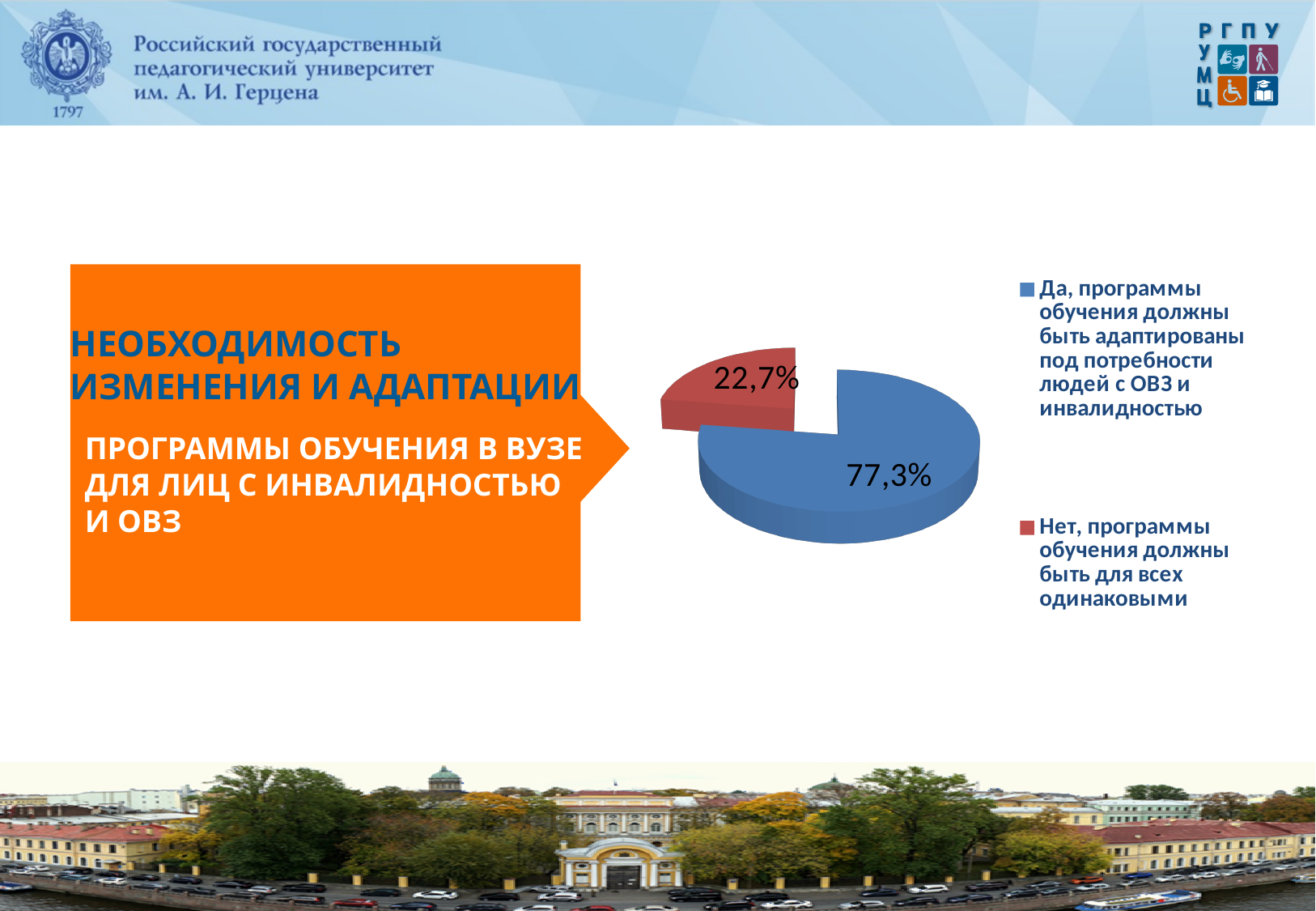
How many slices does the pie chart have? 2 How many entries does the legend of the pie chart list? 2 What colour is the slice labelled 77,3%? Blue What kind of chart is shown on the slide? Pie chart Which slice of the pie is the smallest? Нет, программы обучения должны быть для всех одинаковыми What colour is the slice for "Нет, программы обучения должны быть для всех одинаковыми"? Red What share of the pie corresponds to "Нет, программы обучения должны быть для всех одинаковыми"? 22,7% Which is larger: the "Да, программы обучения должны быть адаптированы..." slice or the "Нет, программы обучения должны быть для всех одинаковыми" slice? Да, программы обучения должны быть адаптированы под потребности людей с ОВЗ и инвалидностью Which slice of the pie is the largest? Да, программы обучения должны быть адаптированы под потребности людей с ОВЗ и инвалидностью What share of the pie corresponds to "Да, программы обучения должны быть адаптированы под потребности людей с ОВЗ и инвалидностью"? 77,3% What is the difference in percentage points between the "Да" slice and the "Нет" slice? 54,6 What is the total of the two slice percentages shown on the pie chart? 100%